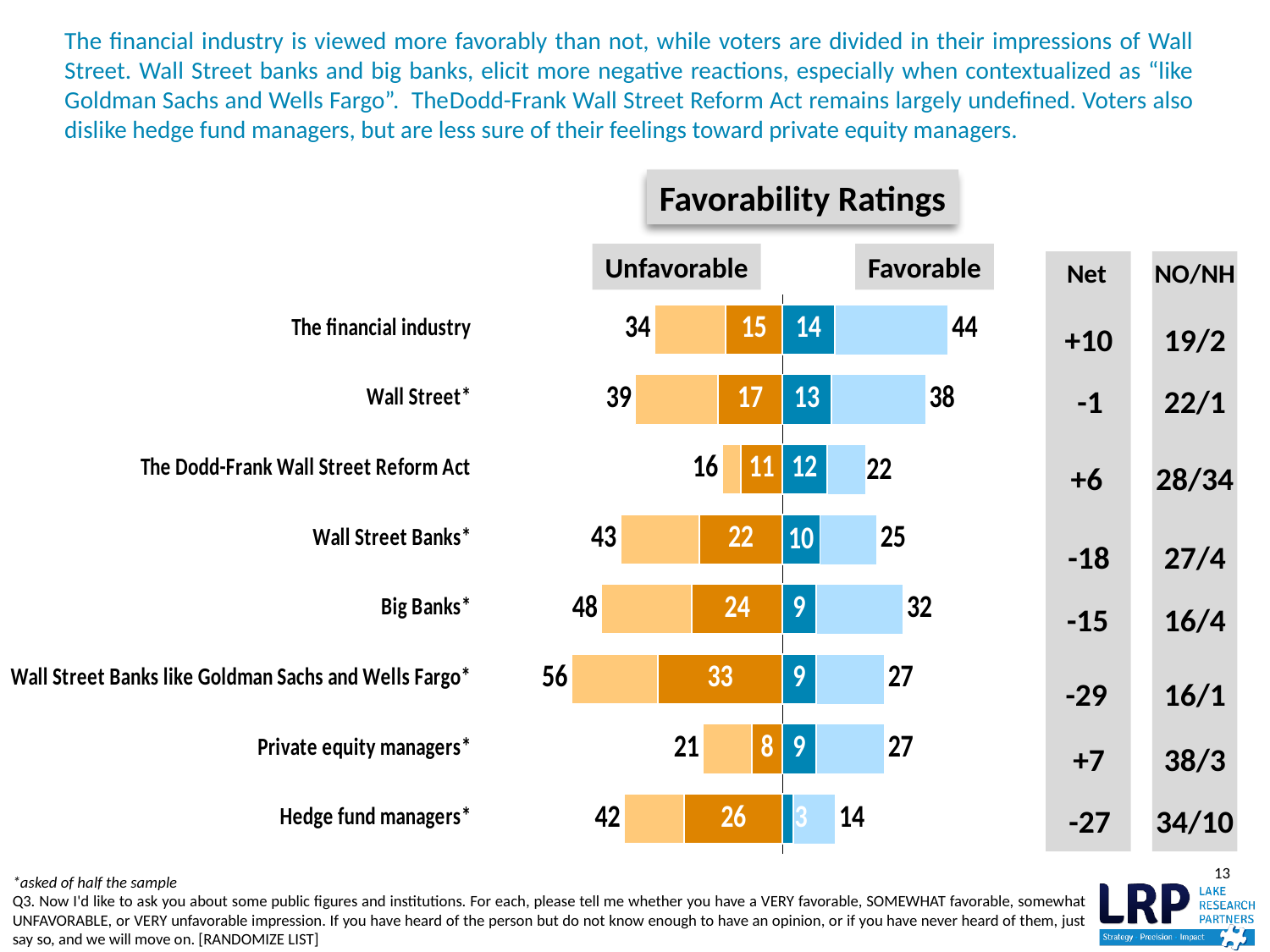
What is the very favorable (dark blue) value for Hedge fund managers? 3 How many categories are shown in the chart? 8 What is the total favorable rating for The financial industry? 44 What type of chart is shown on the slide? Bar chart What is the total unfavorable rating for Big Banks? 48 What is the difference between the total unfavorable and total favorable ratings for Hedge fund managers? 28 Which category has the highest total unfavorable rating? Wall Street Banks like Goldman Sachs and Wells Fargo What is the very unfavorable (dark orange) value for Wall Street Banks like Goldman Sachs and Wells Fargo? 33 Which category has the lowest total favorable rating? Hedge fund managers What is the total favorable rating for The Dodd-Frank Wall Street Reform Act? 22 By how much does the total favorable rating for The financial industry exceed its total unfavorable rating? 10 For Big Banks, which is larger: the total unfavorable rating or the total favorable rating? Total unfavorable